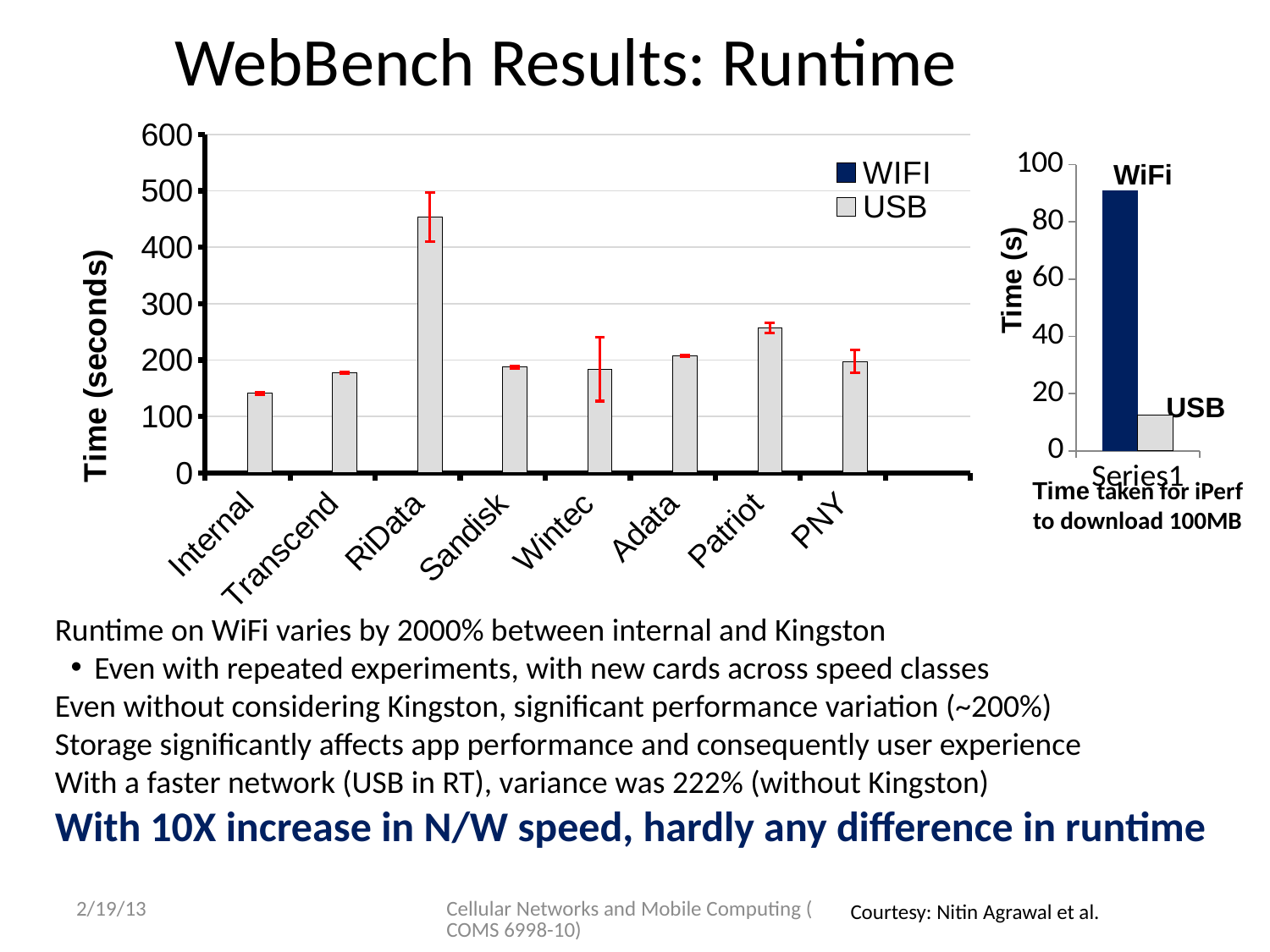
In the small chart on the right (time taken for iPerf to download 100MB), which bar is higher, WiFi or USB? WiFi How many series does the legend of the left chart list? 2 In the left chart, which category has the lowest runtime? Internal How many storage categories are labelled on the x axis of the left chart? 8 What kind of chart is the large chart on the left of the slide? bar chart In the left chart, which storage card has the highest runtime? RiData What is the y-axis title of the left chart? Time (seconds) In the left chart, which is larger, the value for Patriot or the value for PNY? Patriot In the left chart, is the value for Patriot greater or less than 200? greater In the left chart, is the value for Internal greater or less than 200? less In the left chart, is the value for RiData greater or less than 400? greater